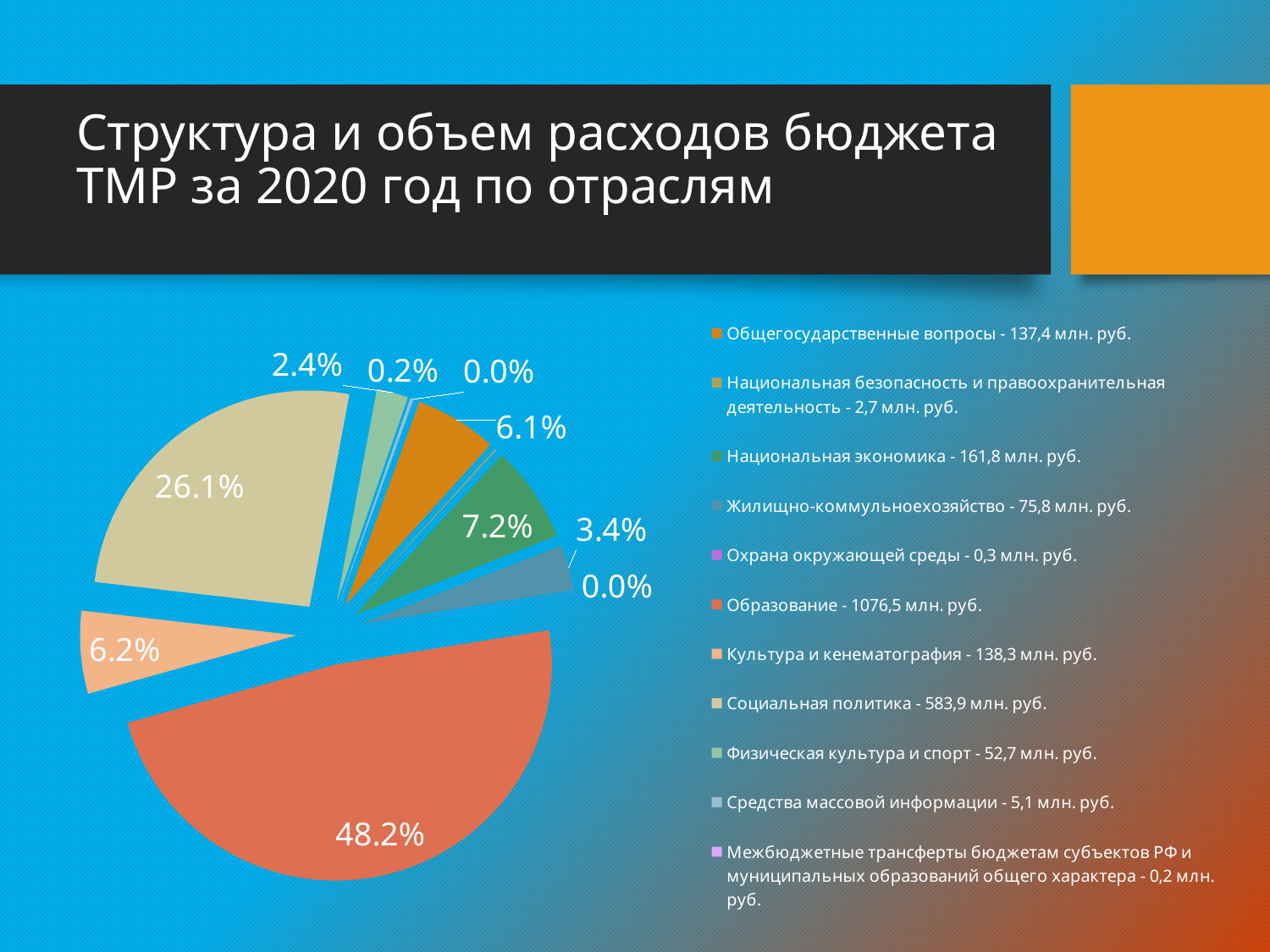
Which category has the largest slice of the pie chart? Образование What percentage share does the Физическая культура и спорт slice show? 2.4% What is the title of the slide containing the pie chart? Структура и объем расходов бюджета ТМР за 2020 год по отраслям What kind of chart is shown on the slide? pie chart According to the legend, what is the expenditure amount for Социальная политика? 583,9 млн. руб. What percentage share does the Образование slice show? 48.2% What percentage share does the Социальная политика slice show? 26.1% What is the difference in percentage points between the Образование slice (48.2%) and the Социальная политика slice (26.1%)? 22.1 According to the legend, what is the expenditure amount for Образование? 1076,5 млн. руб. Which slice is larger: Социальная политика or Национальная экономика? Социальная политика How many categories does the legend of the pie chart list? 11